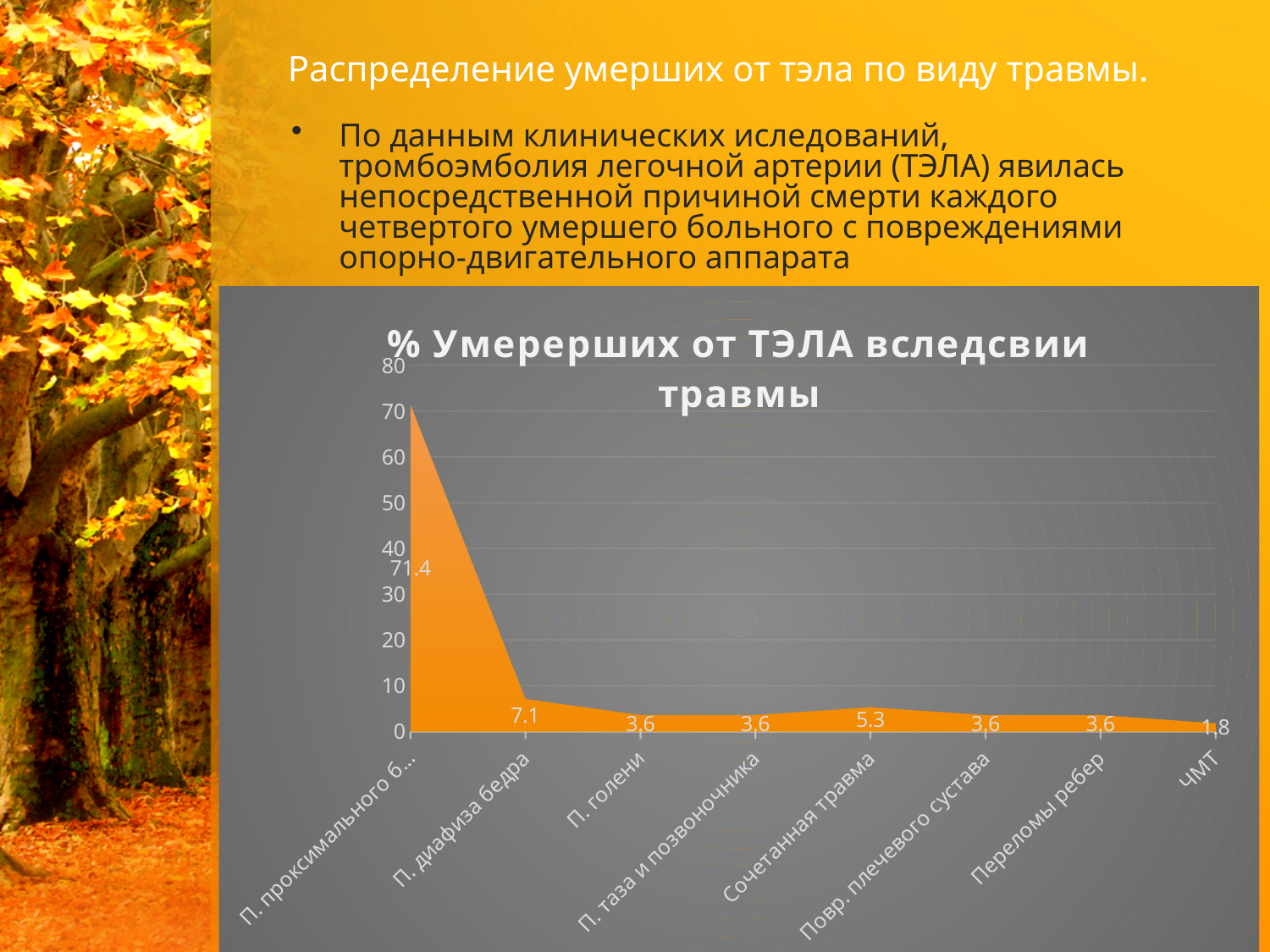
What type of chart is shown on the slide? Area chart What is the title of the chart? % Умерерших от ТЭЛА вследсвии травмы Which category has the lowest value? ЧМТ Is the value for the first category greater or less than 60? greater How many categories are shown on the x axis? 8 What is the difference between the values for П. диафиза бедра and Сочетанная травма? 1.8 What is the value for ЧМТ? 1.8 What is the value for П. диафиза бедра? 7.1 Which is larger, the value for Сочетанная травма or the value for Переломы ребер? Сочетанная травма What is the value for the first category on the x axis? 71.4 What is the value for П. голени? 3.6 What is the value for Сочетанная травма? 5.3